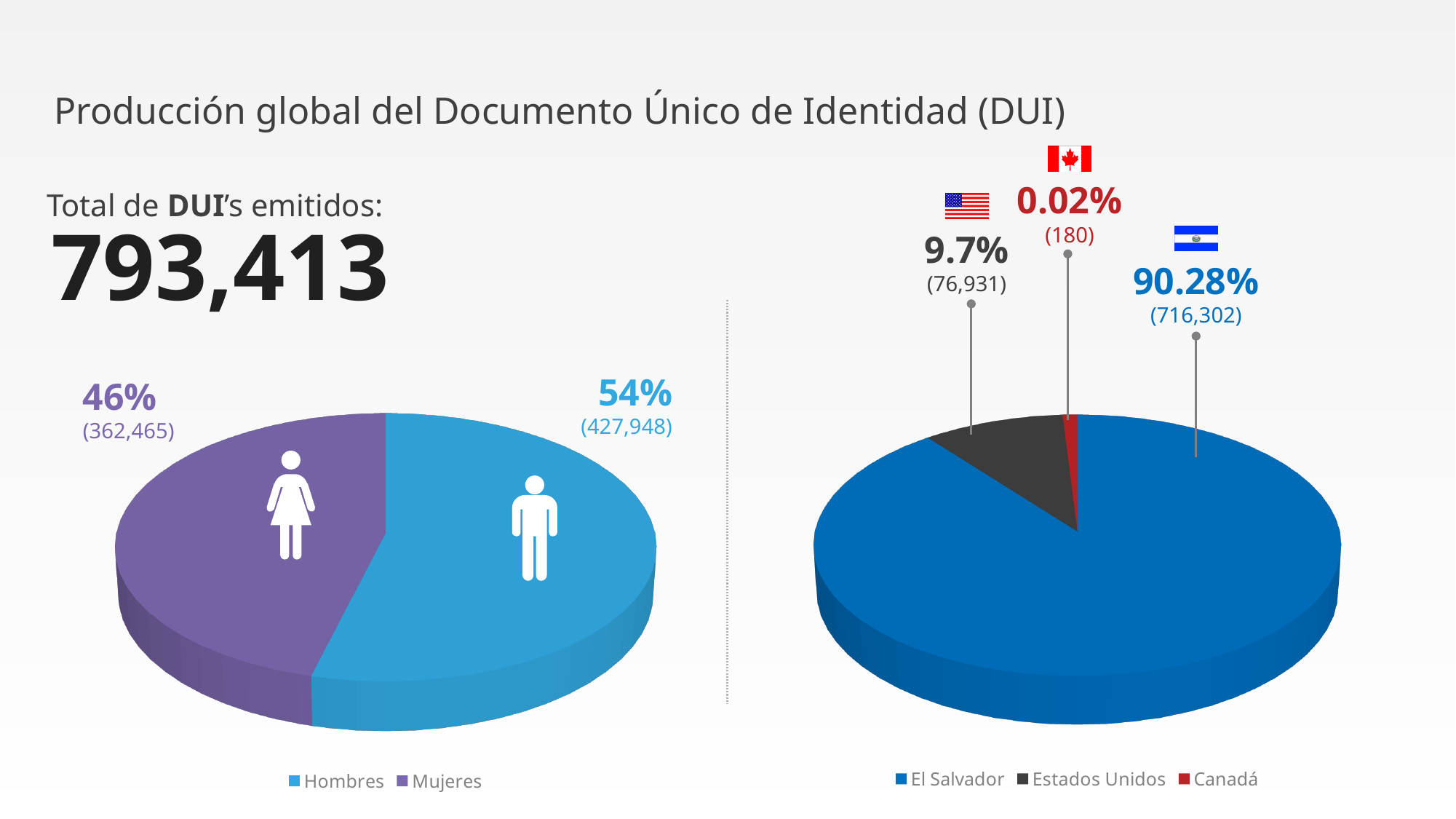
In the left pie chart (Hombres/Mujeres), how many series does the legend list? 2 In the left pie chart (Hombres/Mujeres), what is the difference in count between Hombres and Mujeres? 65,483 In the left pie chart (Hombres/Mujeres), what percentage is shown for Hombres? 54% In the right pie chart (by country), what count is shown for El Salvador? 716,302 In the right pie chart (by country), what percentage is shown for Estados Unidos? 9.7% In the right pie chart (by country), which colour represents Estados Unidos? Dark grey In the right pie chart (by country), what count is shown for Canadá? 180 In the right pie chart (by country), how many categories does the legend list? 3 What type of chart is the right chart (by country)? Pie chart In the left pie chart (Hombres/Mujeres), what count is shown for Mujeres? 362,465 In the right pie chart (by country), which country has the smallest share? Canadá In the left pie chart (Hombres/Mujeres), which category has the larger share? Hombres